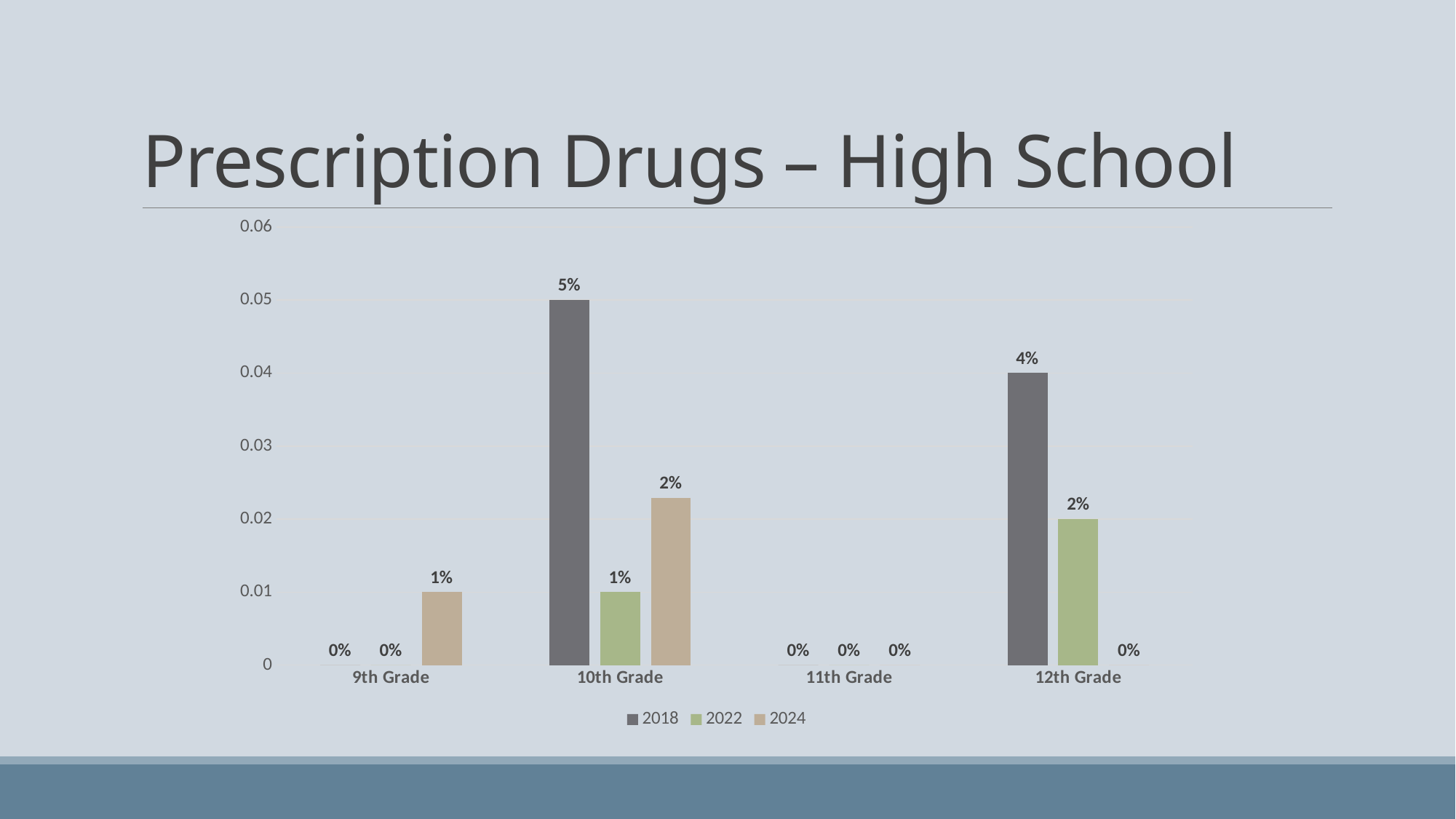
Which is larger, the 2018 value for 10th Grade or the 2018 value for 12th Grade? 10th Grade What is the difference between the 2018 and 2022 values for 10th Grade? 4% How many series does the legend list? 3 How many grade categories are shown on the x axis? 4 What is the value for 2018 in 10th Grade? 5% What is the title of the slide? Prescription Drugs – High School What kind of chart is shown on the slide? Bar chart What is the difference between the 2018 values for 10th Grade and 12th Grade? 1% Which grade has the highest value for 2018? 10th Grade What is the value for 2024 in 9th Grade? 1% What is the value for 2022 in 12th Grade? 2% What is the value for 2018 in 12th Grade? 4%